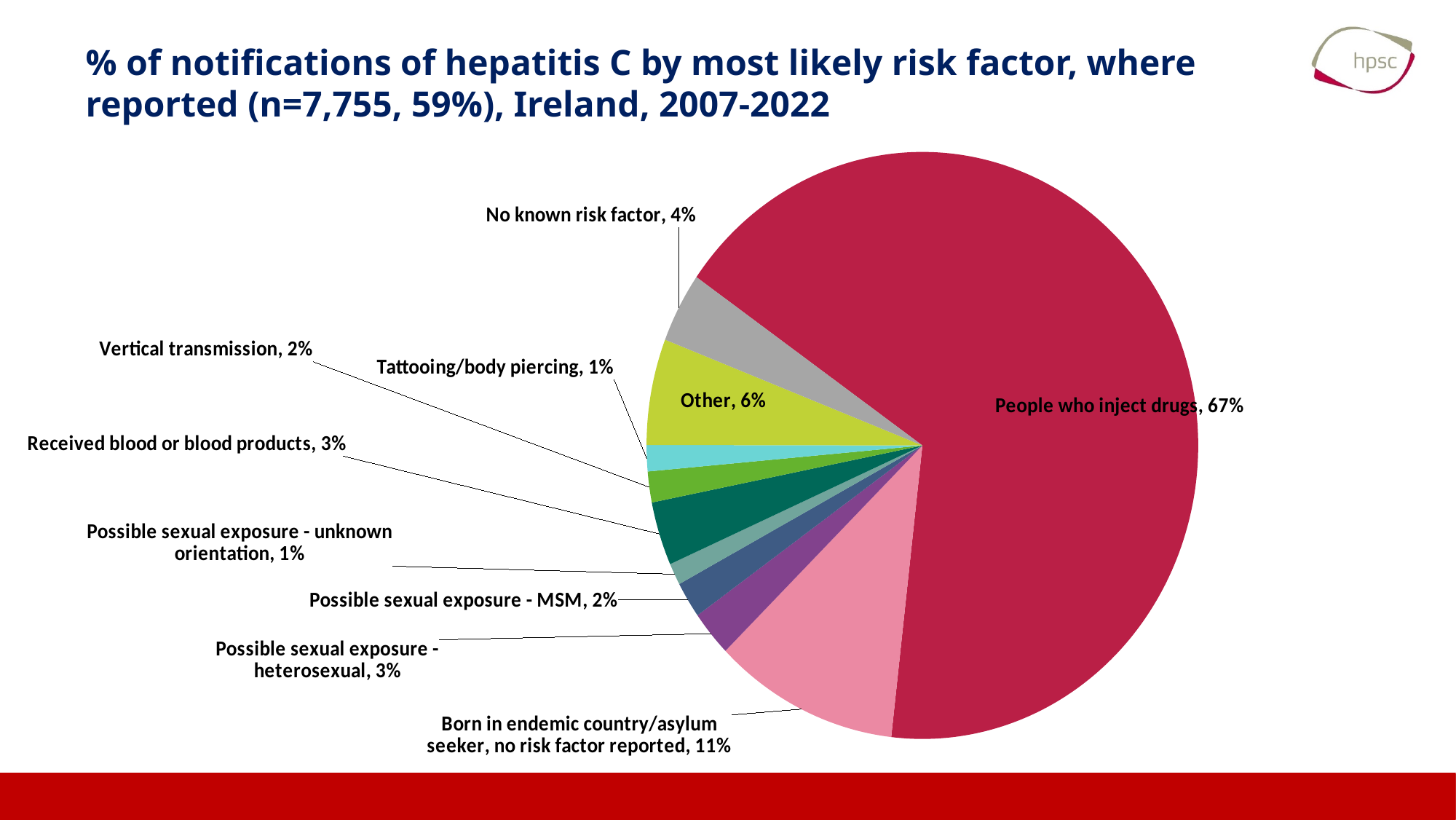
How many risk factor categories are shown in the pie chart? 10 What percentage of hepatitis C notifications is attributed to people who inject drugs? 67% Which is larger: 'Possible sexual exposure - heterosexual' or 'Possible sexual exposure - MSM'? Possible sexual exposure - heterosexual Which is larger: the share for 'Other' or the share for 'No known risk factor'? Other What percentage of notifications is attributed to 'Vertical transmission'? 2% What type of chart is shown on the slide? Pie chart What percentage of notifications is attributed to 'Born in endemic country/asylum seeker, no risk factor reported'? 11% What is the difference in percentage points between 'People who inject drugs' and 'Born in endemic country/asylum seeker, no risk factor reported'? 56 What is the total number of notifications (n) stated in the chart title? 7,755 What percentage of notifications is attributed to 'Received blood or blood products'? 3% Which risk factor accounts for the largest share of hepatitis C notifications? People who inject drugs What percentage of notifications is attributed to 'No known risk factor'? 4%